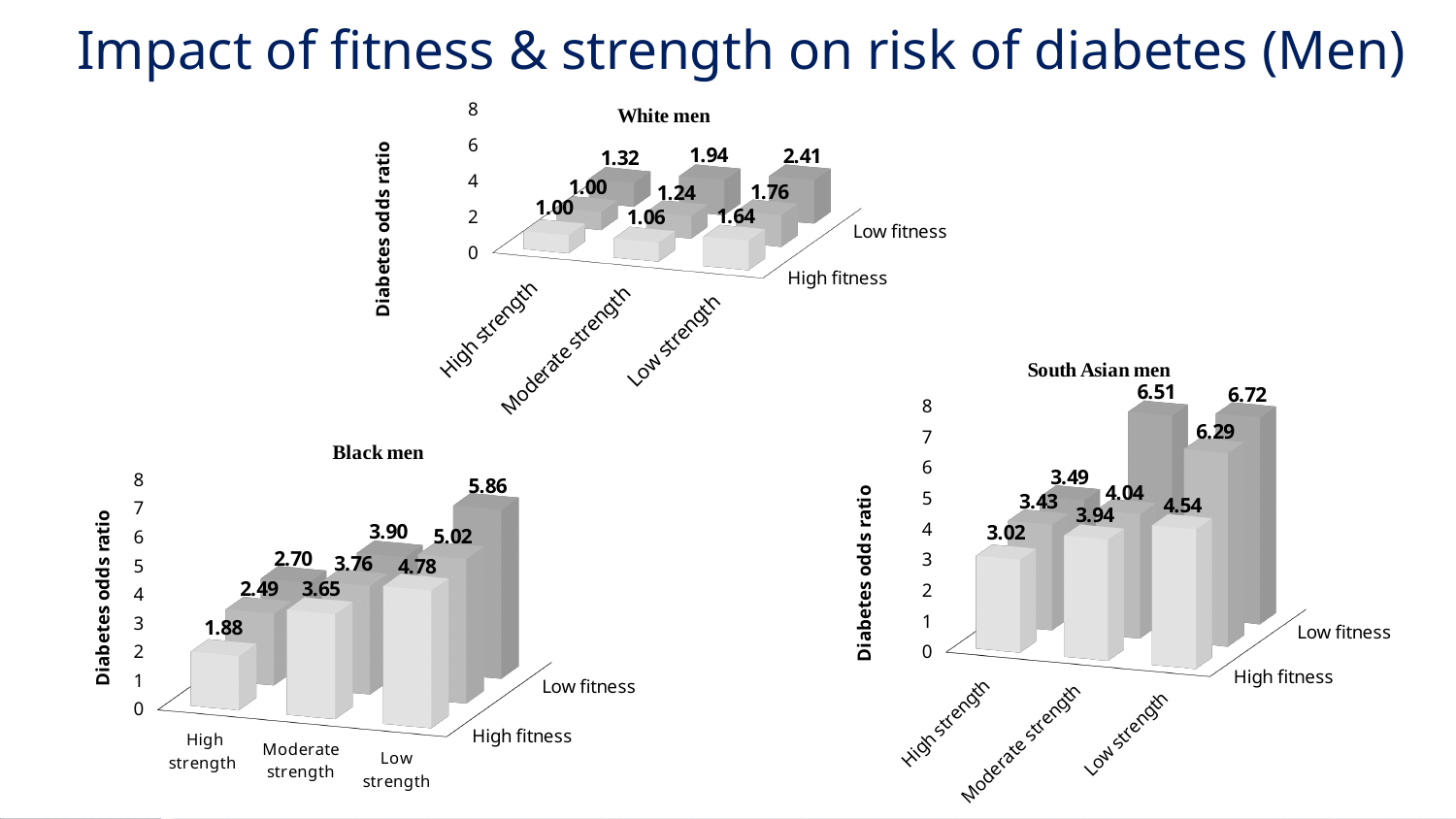
In the White men chart, what is the diabetes odds ratio for high strength at high fitness? 1.00 How many strength categories are shown in the White men chart? 3 In the South Asian men chart, what is the lowest diabetes odds ratio shown? 3.02 In the Black men chart, what is the diabetes odds ratio for low strength at high fitness? 4.78 In the Black men chart, do the high fitness odds ratios rise or fall from high strength to low strength? Rise What is the vertical axis title on the South Asian men chart? Diabetes odds ratio In the White men chart, what is the diabetes odds ratio for low strength at low fitness? 2.41 In the South Asian men chart, which is larger at low fitness: the odds ratio for moderate strength or for low strength? Low strength In the Black men chart, what is the difference between the low strength odds ratio at low fitness and at high fitness? 1.08 What type of chart is used for the Black men data? Bar chart In the South Asian men chart, what is the highest diabetes odds ratio shown? 6.72 In the Black men chart, which strength and fitness combination has the highest diabetes odds ratio? Low strength, low fitness